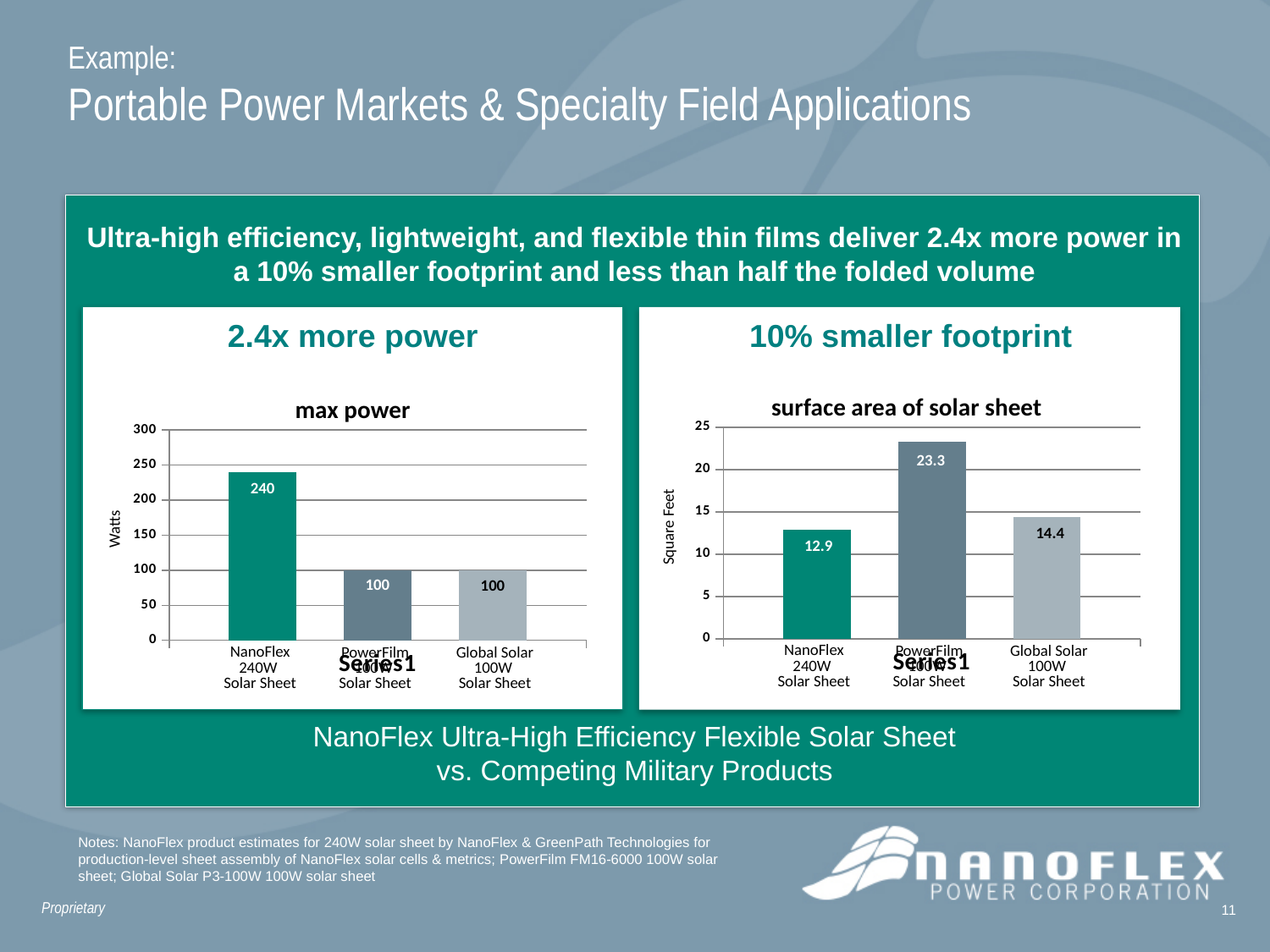
In the "max power" chart, which category has the highest value? NanoFlex 240W Solar Sheet In the "max power" chart, what kind of chart is shown? Bar chart In the "surface area of solar sheet" chart, what is the value for the NanoFlex 240W Solar Sheet? 12.9 In the "max power" chart, what is the value for the Global Solar 100W Solar Sheet? 100 In the "surface area of solar sheet" chart, which is larger: the value for the Global Solar 100W Solar Sheet or the NanoFlex 240W Solar Sheet? Global Solar 100W Solar Sheet In the "max power" chart, what is the value for the NanoFlex 240W Solar Sheet? 240 In the "max power" chart, what is the label on the vertical axis? Watts In the "surface area of solar sheet" chart, what is the value for the PowerFilm 100W Solar Sheet? 23.3 In the "surface area of solar sheet" chart, what is the difference between the PowerFilm 100W Solar Sheet and the Global Solar 100W Solar Sheet? 8.9 In the "surface area of solar sheet" chart, which category has the lowest value? NanoFlex 240W Solar Sheet In the "max power" chart, what is the difference between the NanoFlex 240W Solar Sheet and the PowerFilm 100W Solar Sheet? 140 In the "surface area of solar sheet" chart, how many categories are plotted? 3